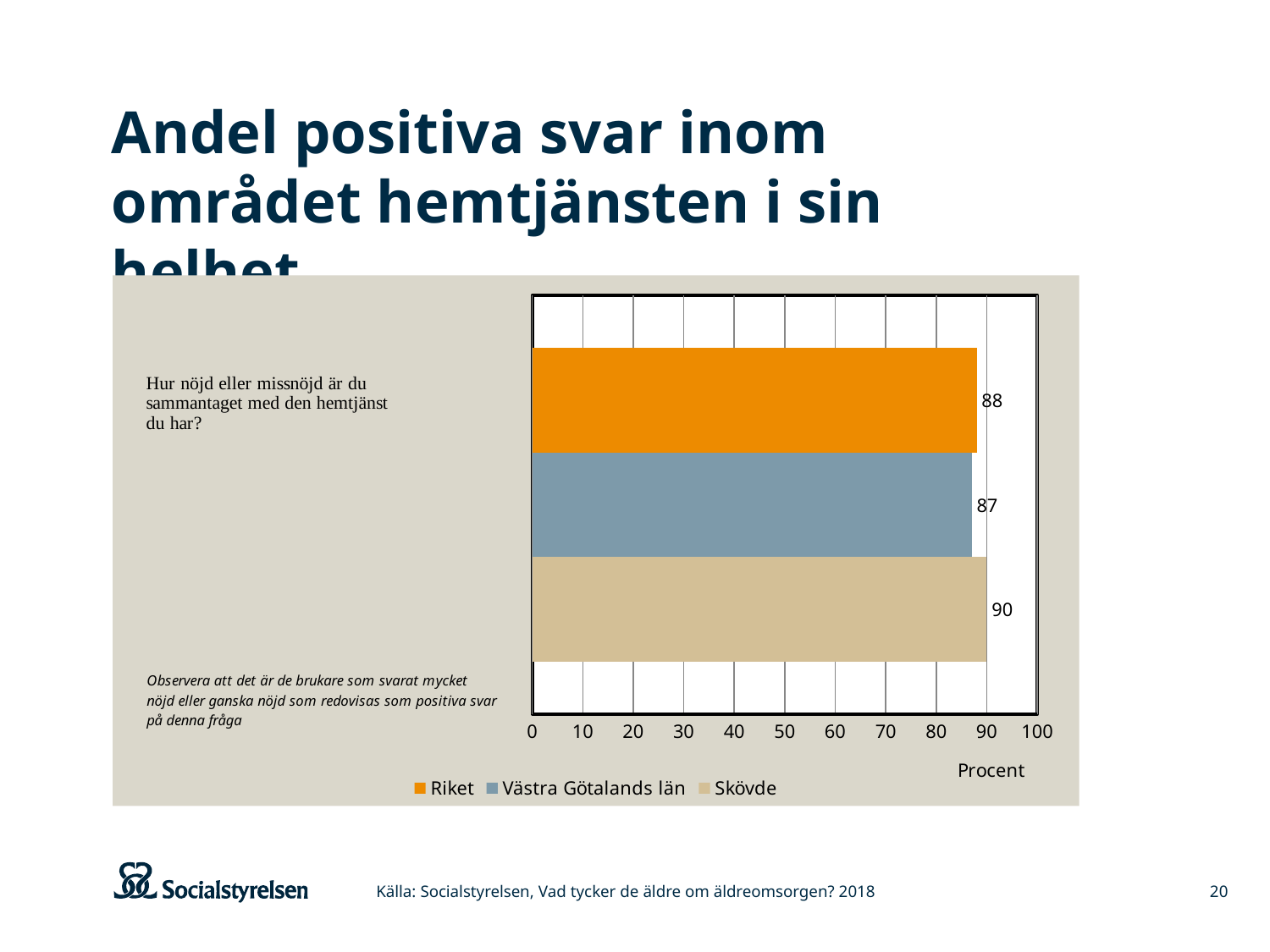
What kind of chart is shown on the slide? Bar chart What is the difference between the values for Skövde and Riket? 2 Which series has the highest value? Skövde What is the value for Riket? 88 What is the value for Västra Götalands län? 87 Which is larger, the value for Skövde or the value for Västra Götalands län? Skövde What is the label of the horizontal axis? Procent What is the difference between the values for Riket and Västra Götalands län? 1 Which series has the lowest value? Västra Götalands län What is the value for Skövde? 90 Is the value for Riket greater or less than 80? greater How many series does the legend list? 3